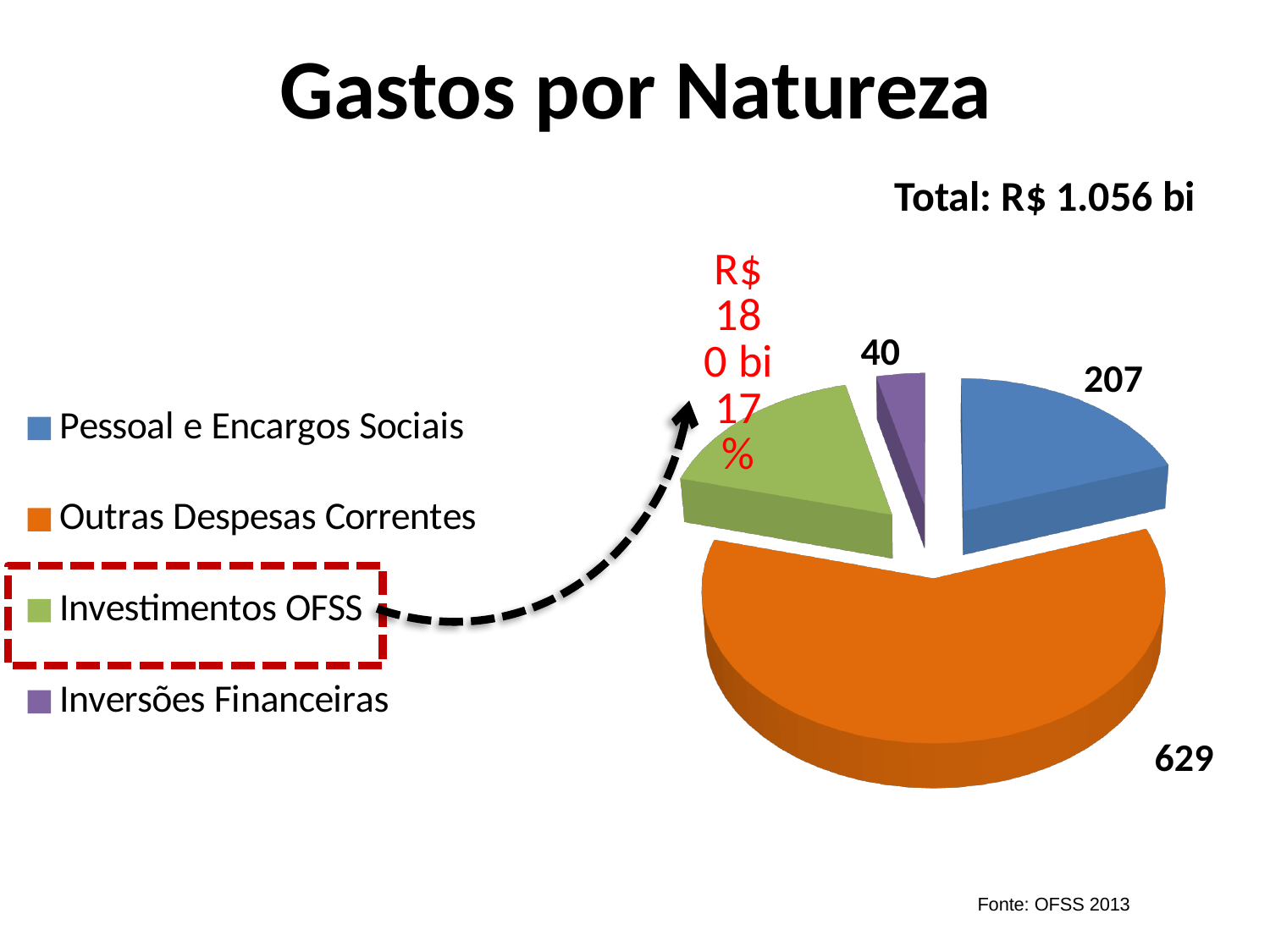
How many categories does the legend list? 4 Which category has the smallest slice? Inversões Financeiras What is the value for Inversões Financeiras? 40 What is the difference between the values for Outras Despesas Correntes and Pessoal e Encargos Sociais? 422 What total is stated on the slide? R$ 1.056 bi What kind of chart is shown on the slide? pie chart Which is larger, Pessoal e Encargos Sociais or Inversões Financeiras? Pessoal e Encargos Sociais What share of the pie does Investimentos OFSS represent? 17% What value is shown for Investimentos OFSS? R$ 180 bi What is the value for Pessoal e Encargos Sociais? 207 Which category has the largest slice? Outras Despesas Correntes What is the value for Outras Despesas Correntes? 629